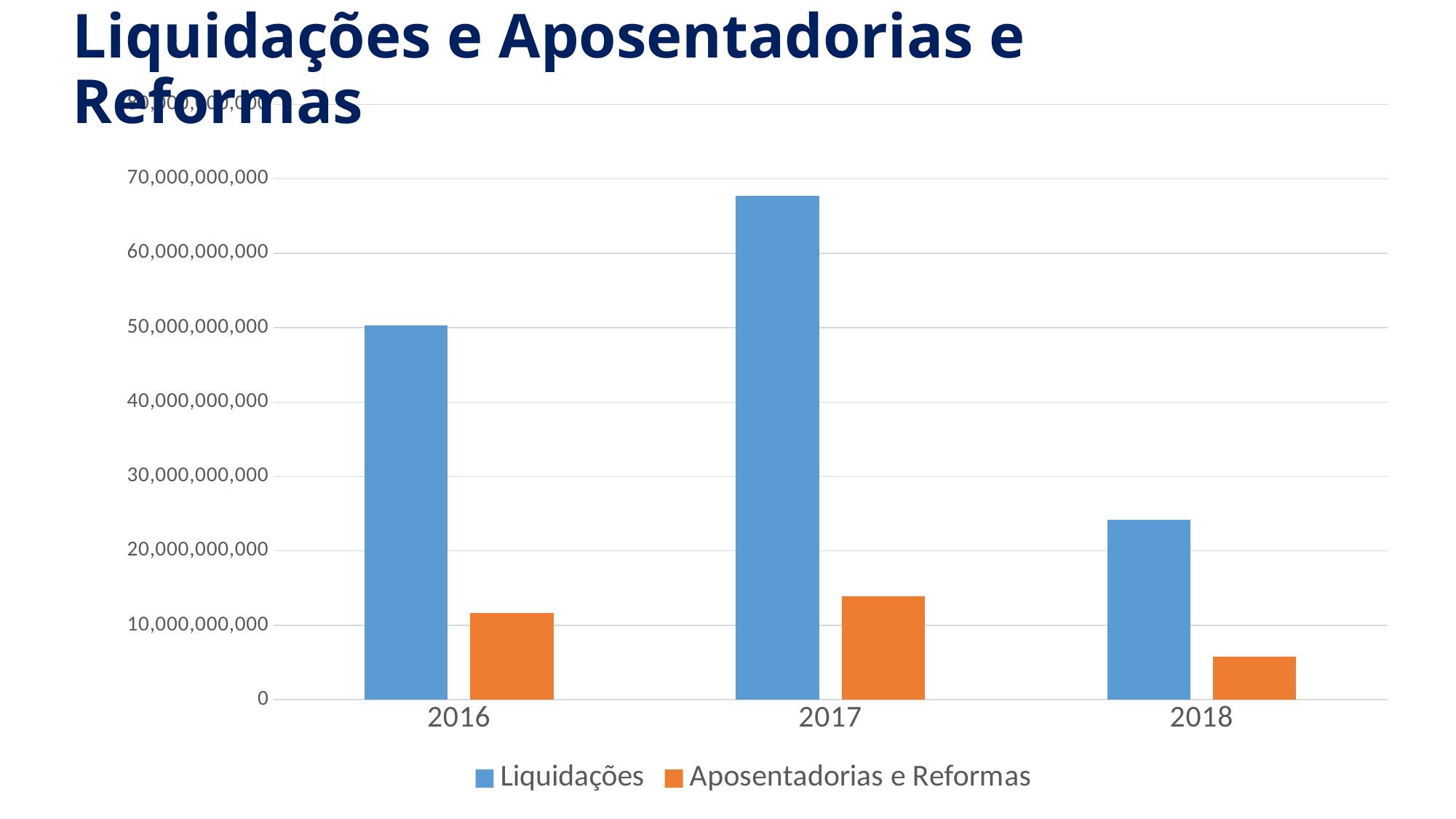
Is the Aposentadorias e Reformas value for 2018 greater or less than 10,000,000,000? less How many years are shown on the x axis? 3 What kind of chart is shown on the slide? bar chart Is the Liquidações value for 2018 greater or less than 30,000,000,000? less Which colour represents the Aposentadorias e Reformas series? orange How many series does the legend list? 2 In which year is the Liquidações value highest? 2017 Does the Liquidações value rise or fall from 2017 to 2018? fall In which year is the Liquidações value lowest? 2018 Is the Liquidações value for 2017 greater or less than 60,000,000,000? greater Which is larger: Liquidações in 2016 or Liquidações in 2018? Liquidações in 2016 In which year is the Aposentadorias e Reformas value lowest? 2018